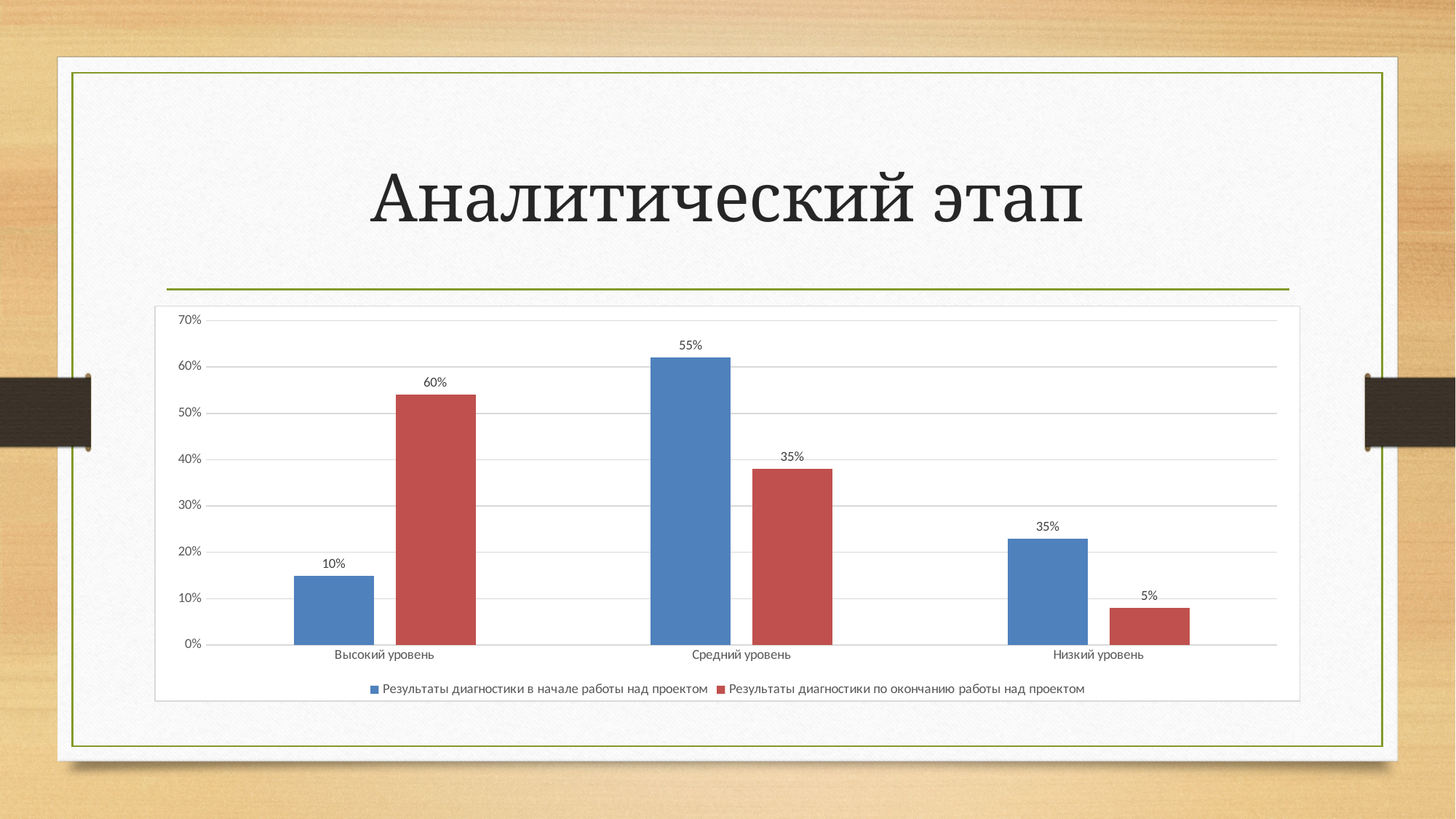
Which category has the lowest value in the series Результаты диагностики по окончанию работы над проектом? Низкий уровень Which category has the highest value in the series Результаты диагностики в начале работы над проектом? Средний уровень For Низкий уровень, which series has the larger value? Результаты диагностики в начале работы над проектом What is the value for Высокий уровень in the series Результаты диагностики в начале работы над проектом? 10% What is the value for Низкий уровень in the series Результаты диагностики по окончанию работы над проектом? 5% What is the difference between the two series' values for Высокий уровень? 50% What is the value for Высокий уровень in the series Результаты диагностики по окончанию работы над проектом? 60% What colour are the bars for the series Результаты диагностики по окончанию работы над проектом? Red What kind of chart is shown on the slide? Bar chart How many categories are shown on the x axis? 3 How many series does the legend list? 2 What is the value for Средний уровень in the series Результаты диагностики в начале работы над проектом? 55%